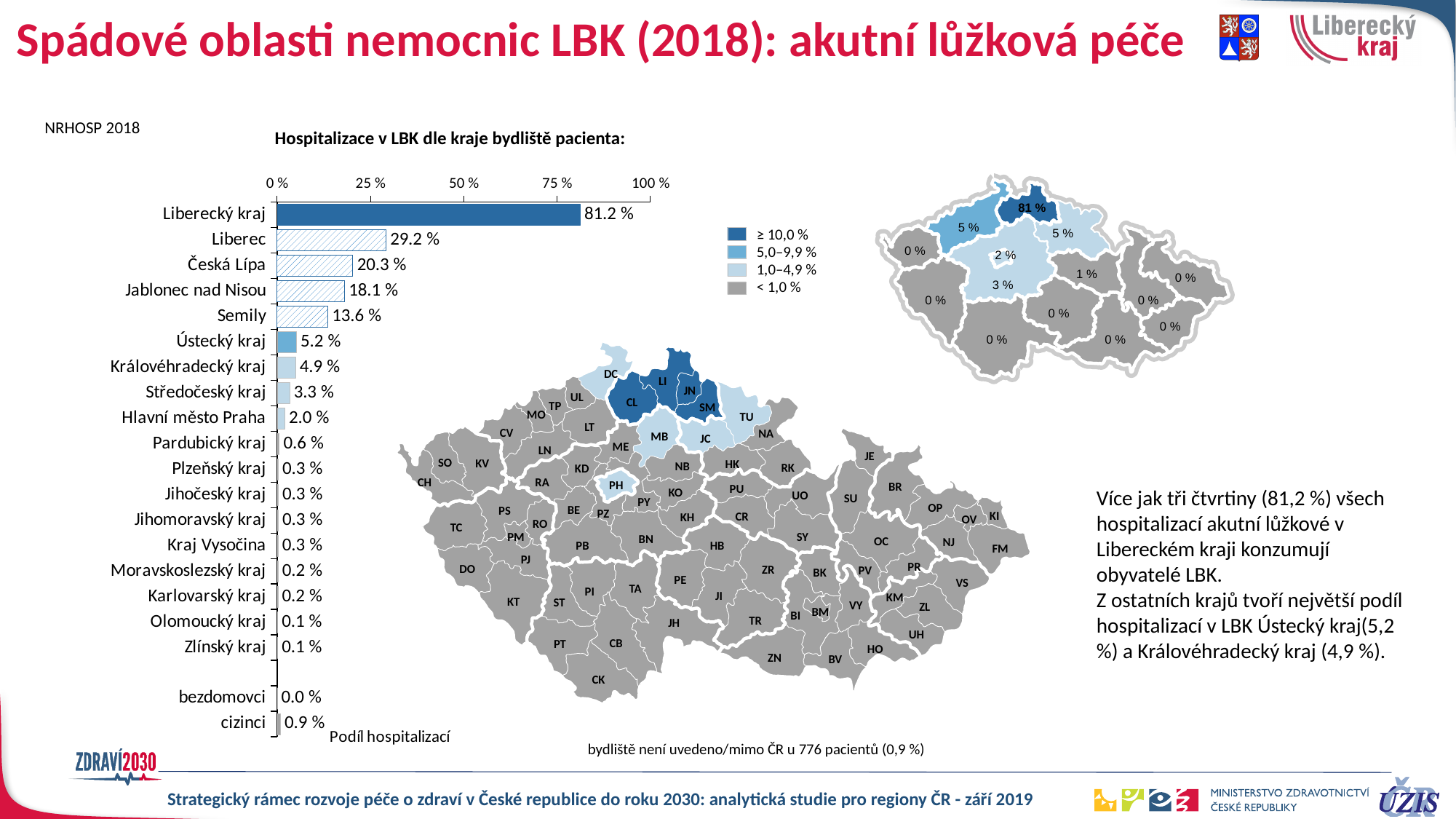
Which has a larger value, Jablonec nad Nisou or Semily? Jablonec nad Nisou What is the value for Česká Lípa in the bar chart? 20.3 % Which category has the highest value in the bar chart? Liberecký kraj What is the difference between the values for Liberec and Česká Lípa? 8.9 % What is the value for Liberecký kraj in the bar chart? 81.2 % What kind of chart is shown on the slide? bar chart What is the value for cizinci in the bar chart? 0.9 % What is the value for Královéhradecký kraj in the bar chart? 4.9 % What is the difference between the values for Ústecký kraj and Královéhradecký kraj? 0.3 % Which category has the lowest value in the bar chart? bezdomovci Is the value for Liberecký kraj greater or less than 75 %? greater What is the title of the bar chart? Hospitalizace v LBK dle kraje bydliště pacienta: